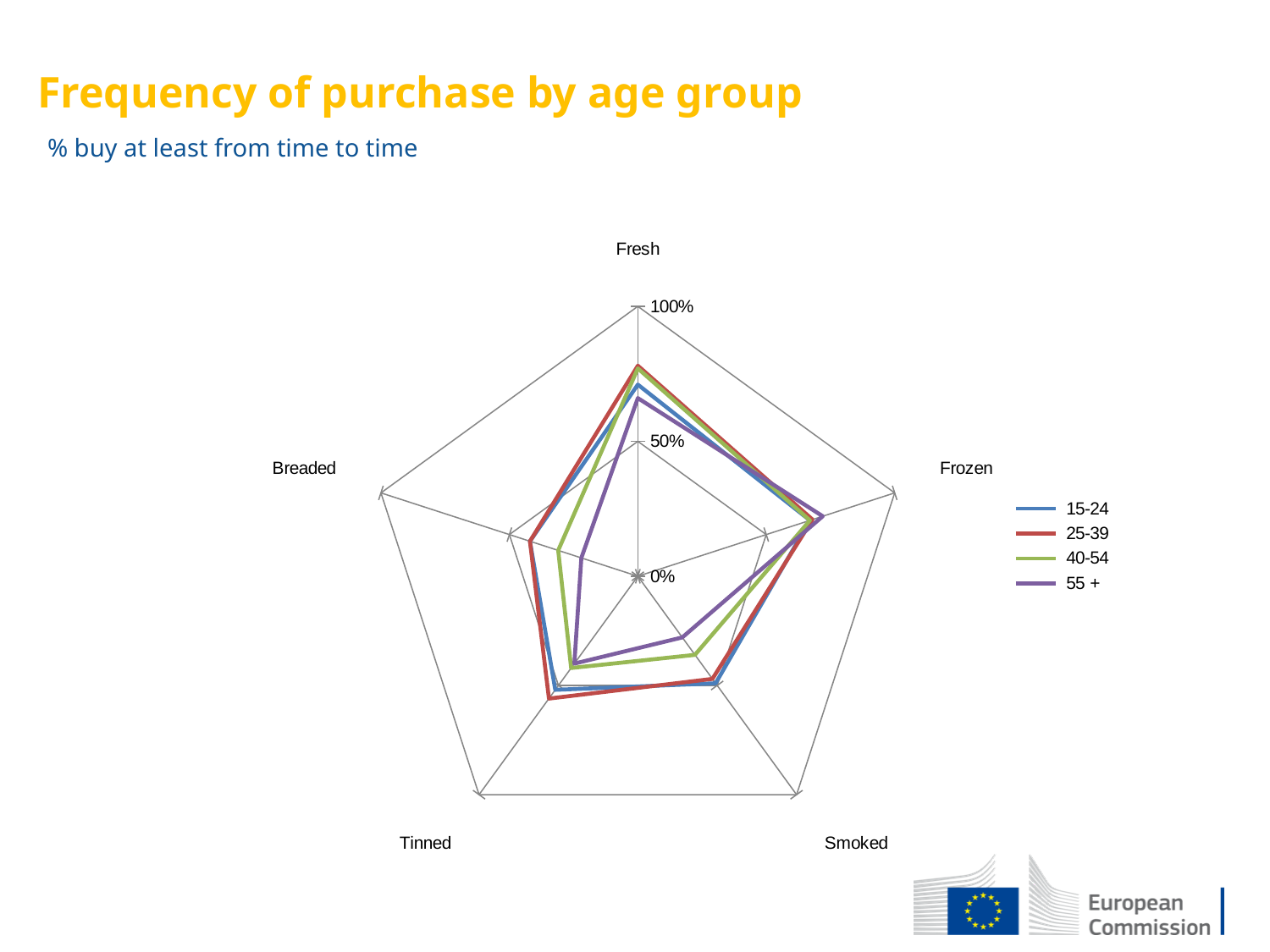
For Smoked, which is larger: the value for 25-39 or the value for 55 +? 25-39 Which age groups are listed in the legend? 15-24, 25-39, 40-54, 55 + Which age group has the lowest value for Smoked? 55 + What kind of chart is shown on the slide? Radar chart How many product categories are plotted on the radar chart? 5 Is the value for Frozen in the 15-24 age group greater or less than 50%? greater Is the value for Breaded in the 55 + age group greater or less than 50%? less How many age groups does the legend list? 4 Is the value for Smoked in the 55 + age group greater or less than 50%? less What is the title of the chart on the slide? Frequency of purchase by age group Which age group has the lowest value for Breaded? 55 +